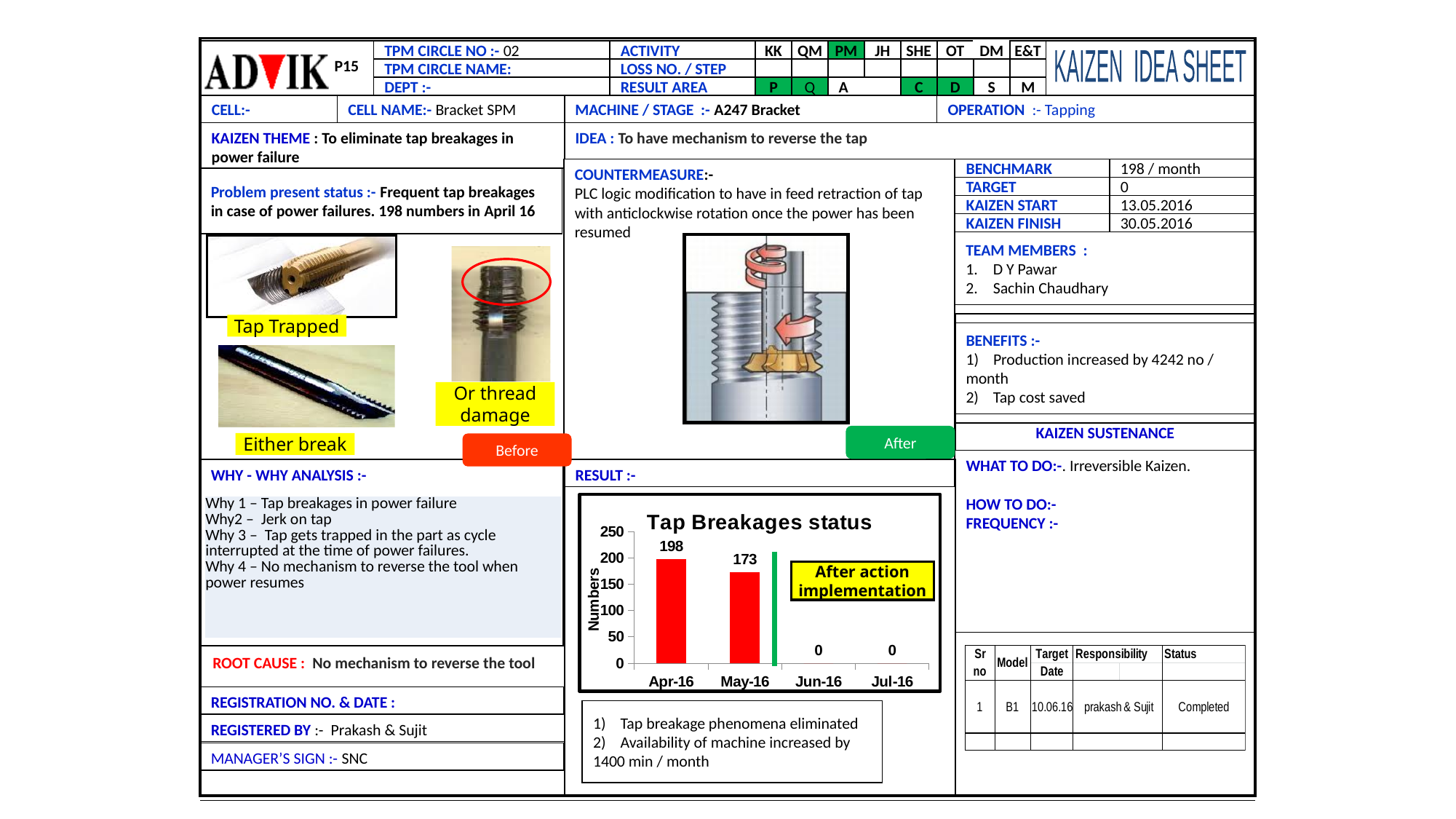
Which month has the highest value in the Tap Breakages status chart? Apr-16 What is the difference between the Apr-16 and May-16 values in the Tap Breakages status chart? 25 What is the value for May-16 in the Tap Breakages status chart? 173 Is the value for May-16 in the Tap Breakages status chart greater or less than 150? greater How many months are shown on the x axis of the Tap Breakages status chart? 4 Do the values in the Tap Breakages status chart rise or fall from Apr-16 to Jul-16? fall What kind of chart is the Tap Breakages status chart? bar chart Which is larger in the Tap Breakages status chart, Apr-16 or May-16? Apr-16 What is the value for Apr-16 in the Tap Breakages status chart? 198 What is the title of the chart on the slide? Tap Breakages status What is the y-axis label of the Tap Breakages status chart? Numbers What is the value for Jun-16 in the Tap Breakages status chart? 0